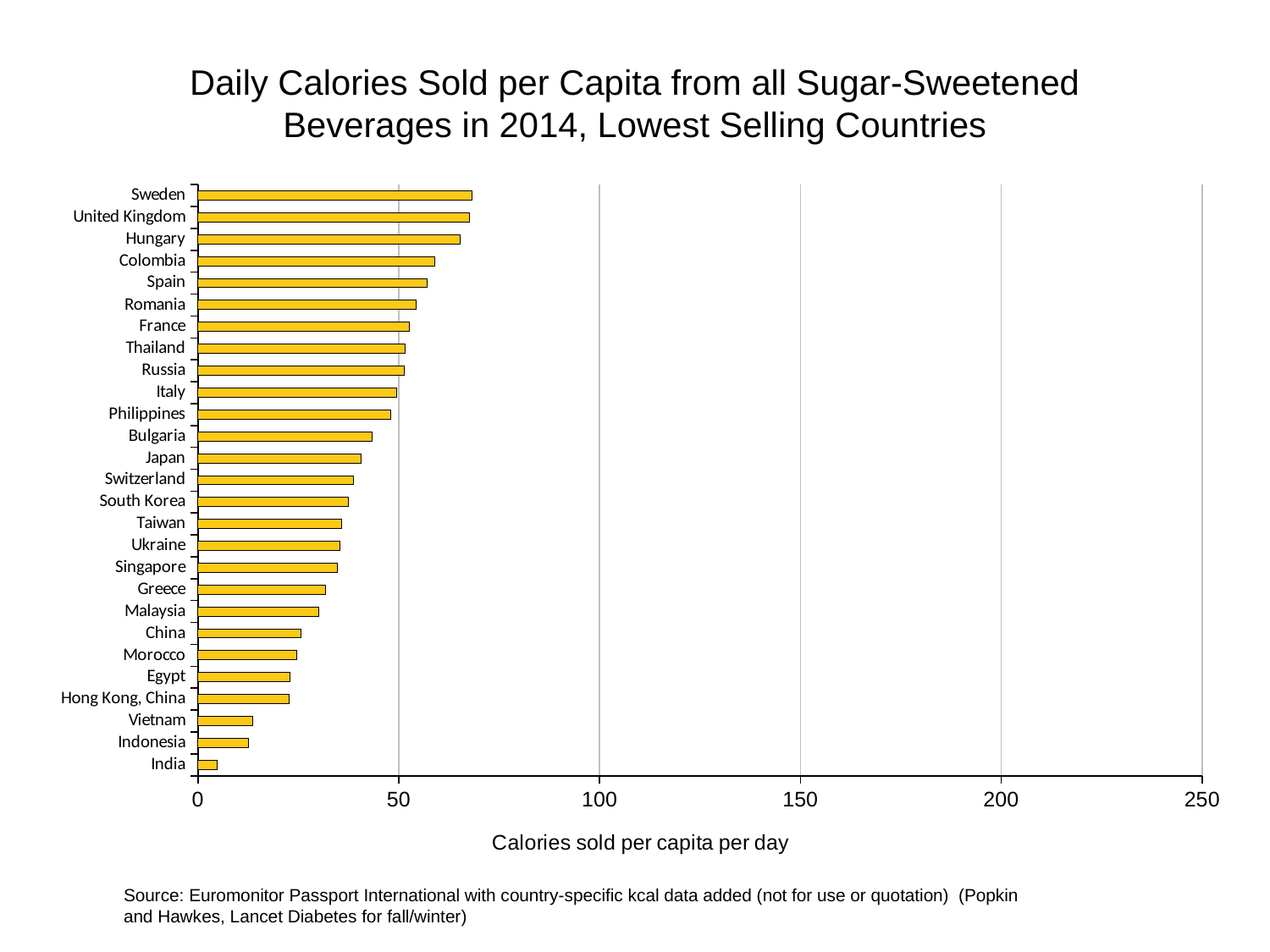
What kind of chart is shown on the slide? Bar chart Which has a higher value, Colombia or Japan? Colombia Which has a higher value, Greece or Egypt? Greece What is the label of the horizontal axis? Calories sold per capita per day Is the value for Colombia greater or less than 50 calories per capita per day? greater Is the value for Sweden greater or less than 50 calories per capita per day? greater Do the bar values increase or decrease going from the top of the chart (Sweden) to the bottom (India)? Decrease How many countries are plotted in the chart? 27 Is the value for India greater or less than 50 calories per capita per day? less Which country has the lowest daily calories sold per capita from sugar-sweetened beverages? India